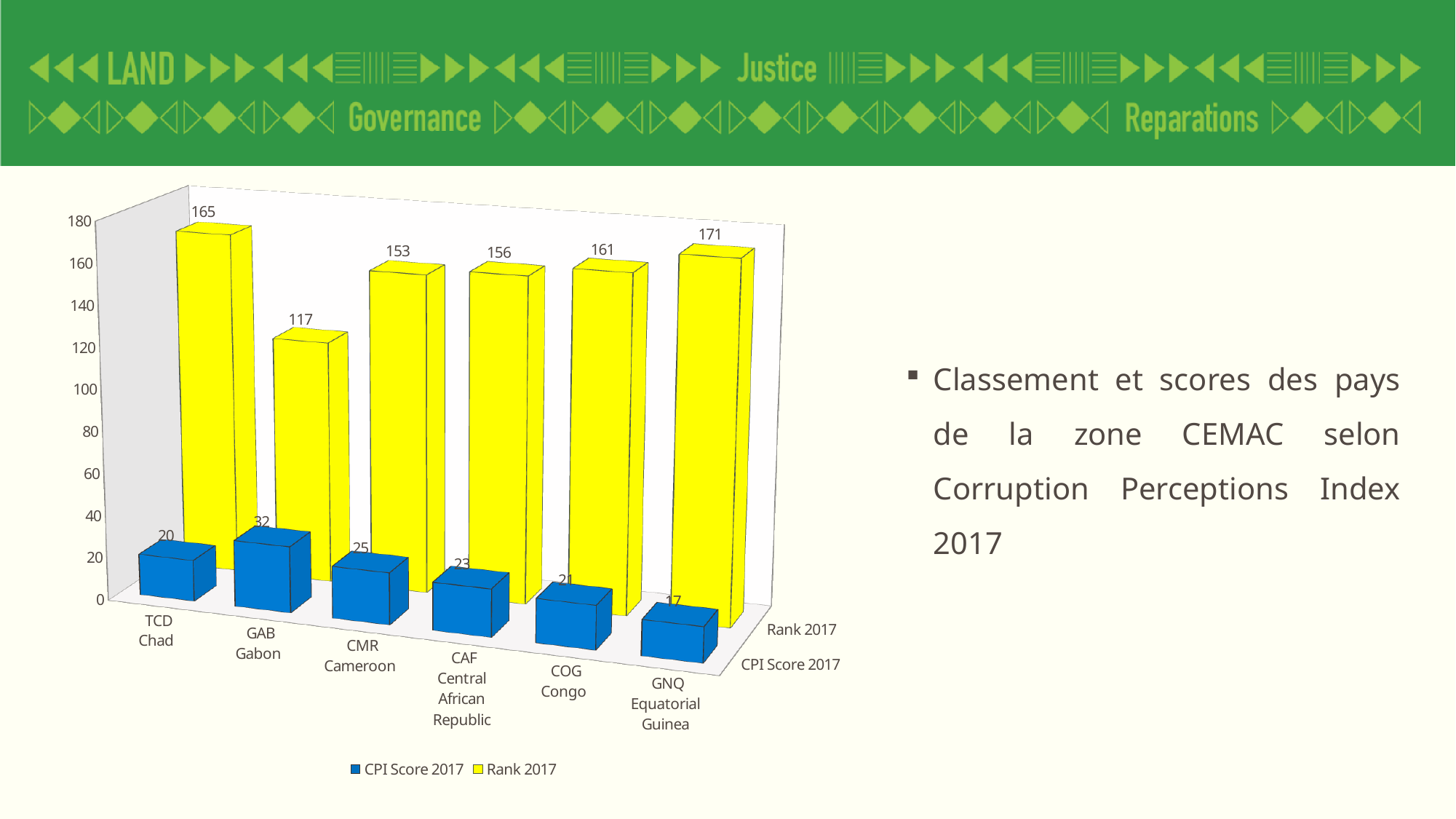
What is the CPI Score 2017 for GNQ Equatorial Guinea? 17 Which country has the highest CPI Score 2017? GAB Gabon Which colour represents the Rank 2017 series? Yellow What is the Rank 2017 value for GAB Gabon? 117 How many series does the legend list? 2 What is the difference between the Rank 2017 values of GNQ Equatorial Guinea and GAB Gabon? 54 Which country has the highest Rank 2017 value? GNQ Equatorial Guinea How many countries are shown on the x axis? 6 Which country has the lowest CPI Score 2017? GNQ Equatorial Guinea Which is larger, the CPI Score 2017 for CMR Cameroon or for COG Congo? CMR Cameroon What kind of chart is shown on the slide? Bar chart What is the Rank 2017 value for TCD Chad? 165